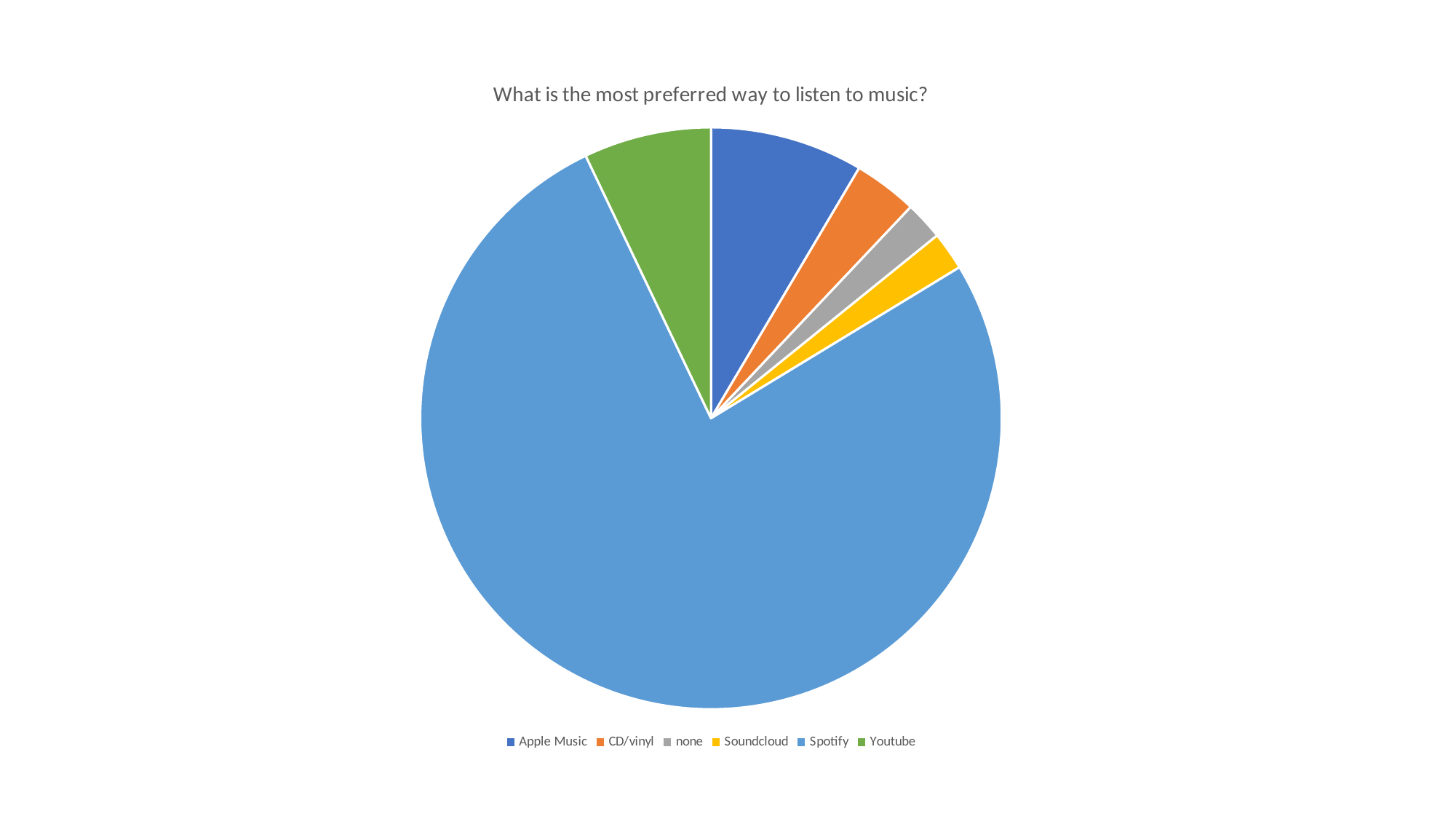
Which is larger, the slice for Spotify or the slice for Youtube? Spotify Which is larger, the slice for Apple Music or the slice for CD/vinyl? Apple Music What kind of chart is shown on the slide? pie chart What is the title of the chart? What is the most preferred way to listen to music? How many categories does the pie chart have? 6 Which category has the largest slice of the pie? Spotify Which is larger, the slice for Youtube or the slice for Soundcloud? Youtube What colour is the Spotify slice in the pie chart? light blue Which category is shown in yellow in the legend? Soundcloud How many entries does the legend list? 6